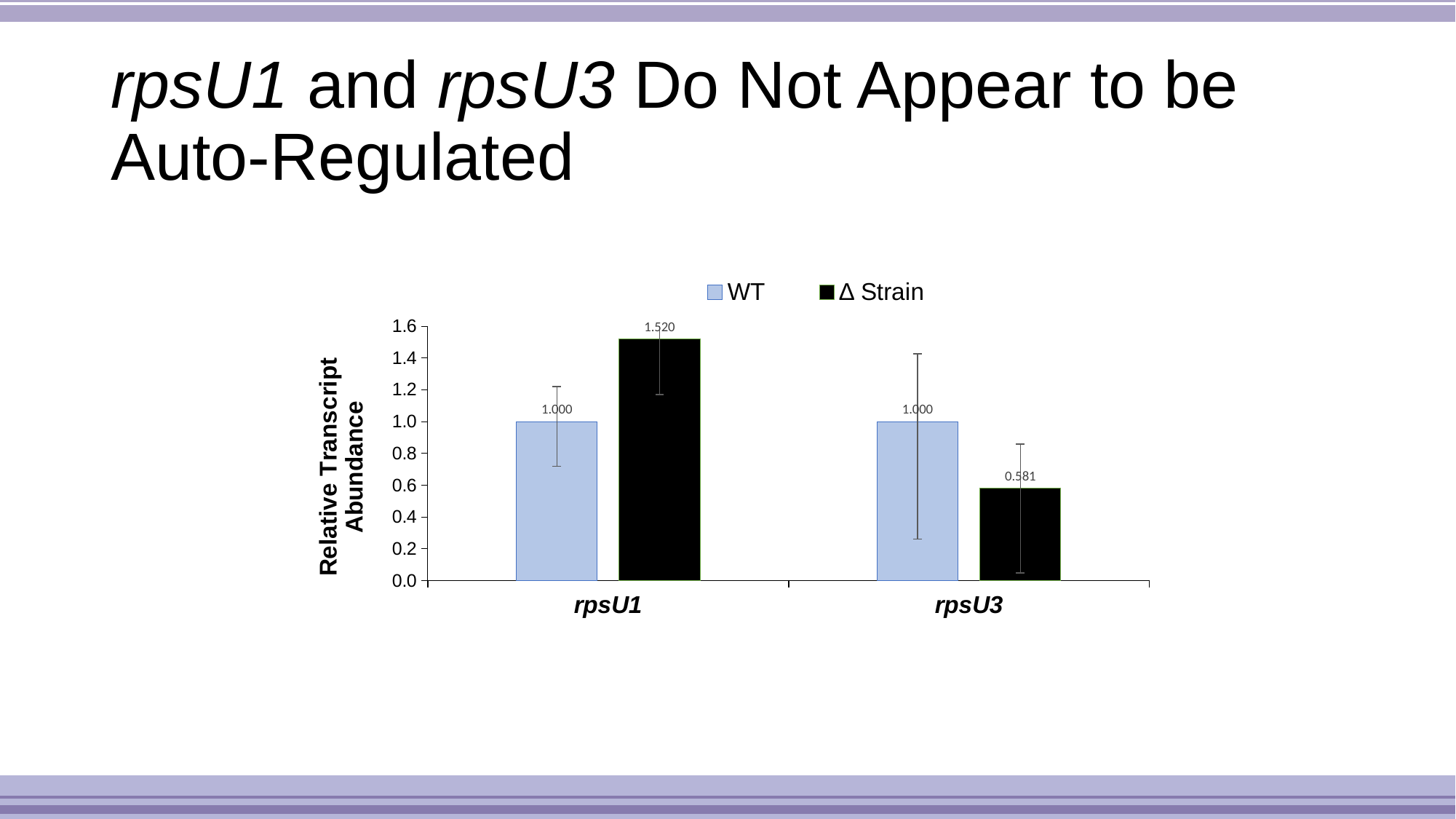
What is the WT value for rpsU1? 1.000 For rpsU3, which is larger, the WT value or the Δ Strain value? WT Which gene has the highest Δ Strain value? rpsU1 What is the Δ Strain value for rpsU1? 1.520 How many series does the legend list? 2 What is the difference between the Δ Strain values for rpsU1 and rpsU3? 0.939 What kind of chart is shown on the slide? Bar chart For rpsU1, which is larger, the WT value or the Δ Strain value? Δ Strain What is the Δ Strain value for rpsU3? 0.581 Which gene has the lowest Δ Strain value? rpsU3 How many genes are shown on the x axis? 2 What is the WT value for rpsU3? 1.000